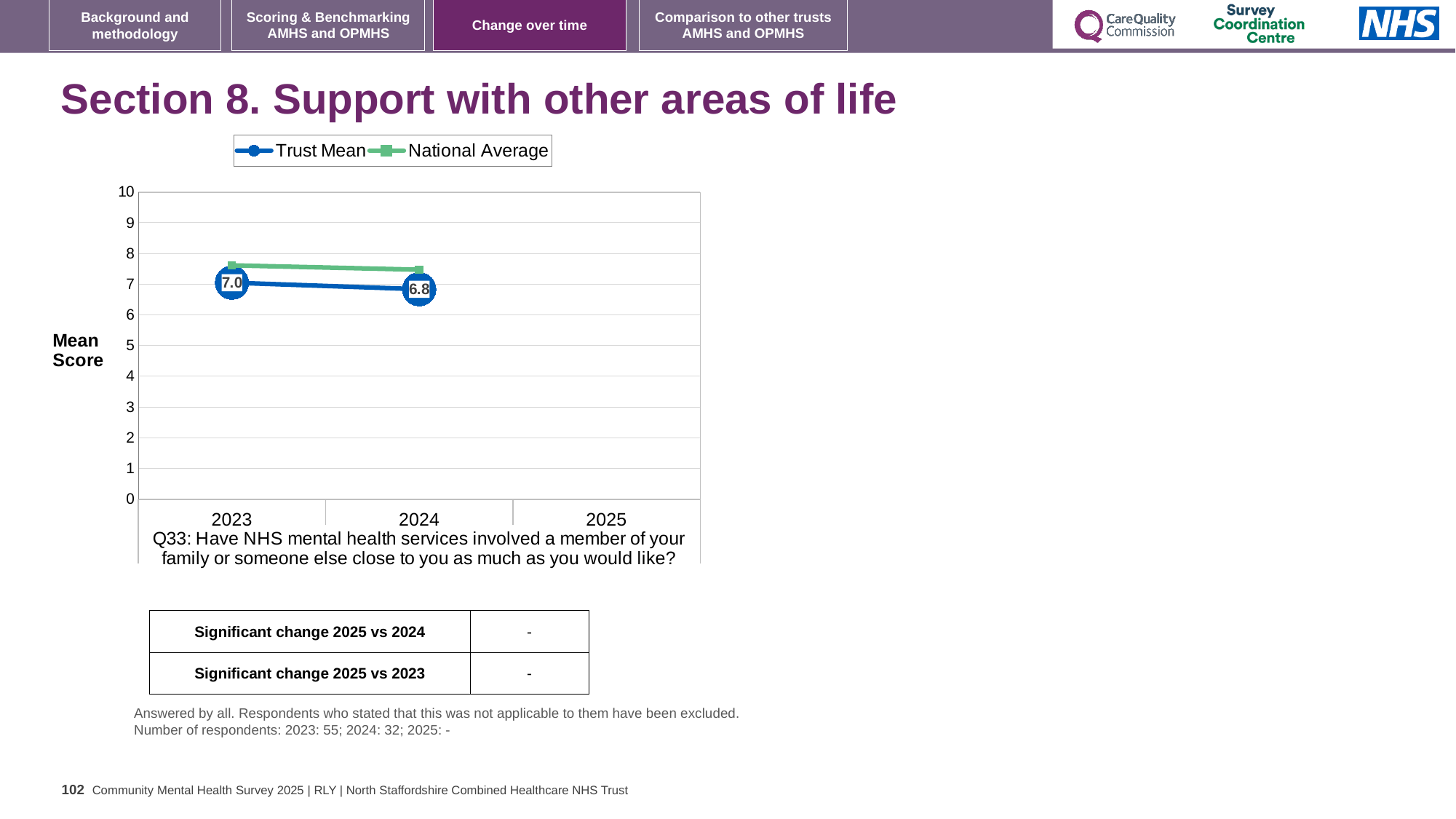
Is the National Average for 2024 greater or less than 8? less Is the National Average for 2023 greater or less than 7? greater Does the Trust Mean rise or fall from 2023 to 2024? fall What is the Trust Mean score for 2024? 6.8 What is the Trust Mean score for 2023? 7.0 Which year has the higher Trust Mean score, 2023 or 2024? 2023 What kind of chart is shown on the slide? line chart How many years are shown on the x axis? 3 How many series does the legend list? 2 What is the difference between the Trust Mean scores for 2023 and 2024? 0.2 In 2024, which is higher, the Trust Mean or the National Average? National Average What is the label of the y axis? Mean Score